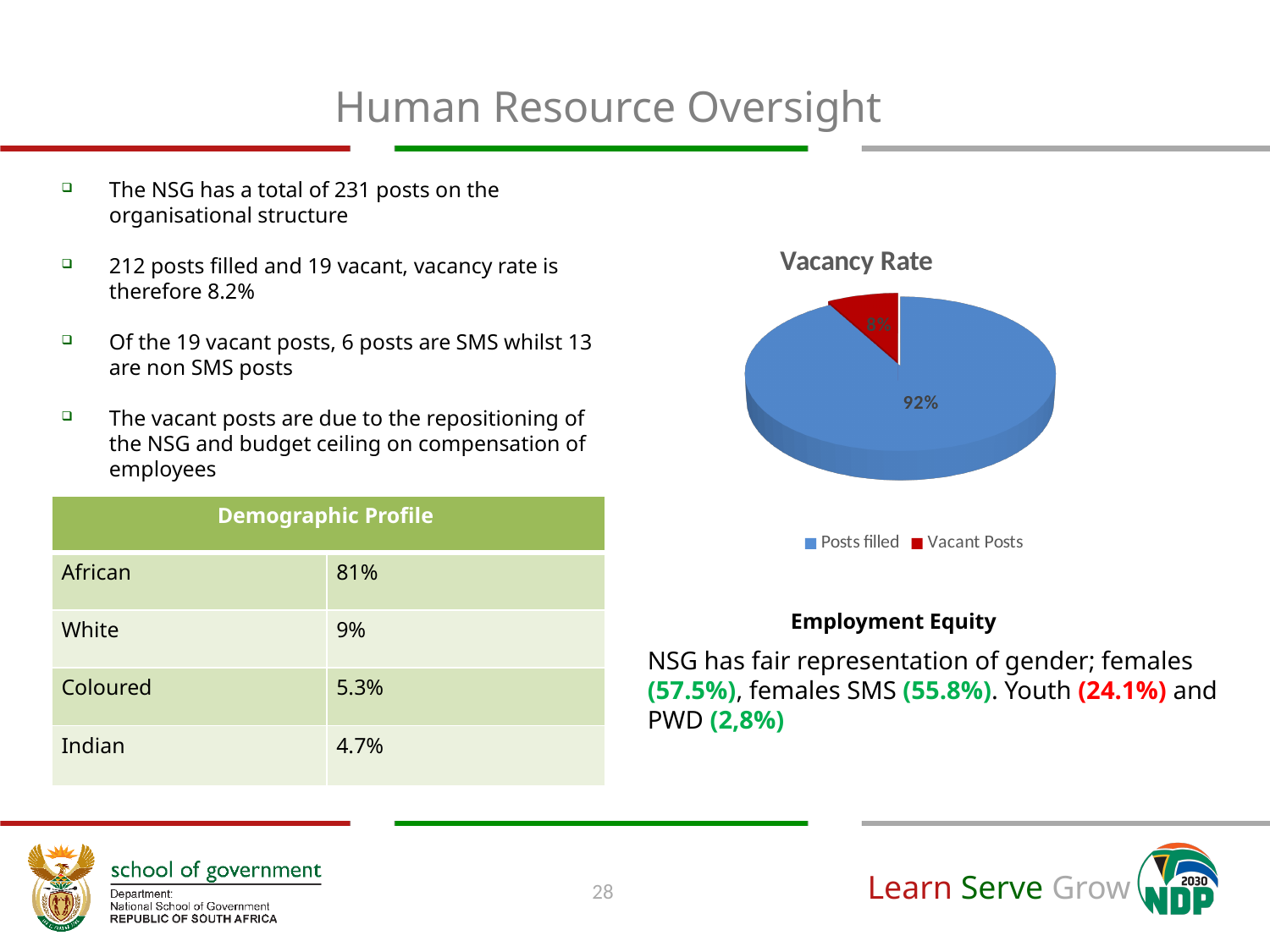
What colour is the Vacant Posts slice in the pie chart? red Which slice of the pie chart is the largest? Posts filled What kind of chart is shown on the slide? pie chart What percentage of the pie chart is Vacant Posts? 8% What is the title of the pie chart? Vacancy Rate How many entries does the legend of the pie chart list? 2 How many slices does the pie chart have? 2 Which is larger in the pie chart, Posts filled or Vacant Posts? Posts filled What is the difference in percentage points between Posts filled and Vacant Posts in the pie chart? 84 What percentage of the pie chart is Posts filled? 92% Which slice of the pie chart is the smallest? Vacant Posts